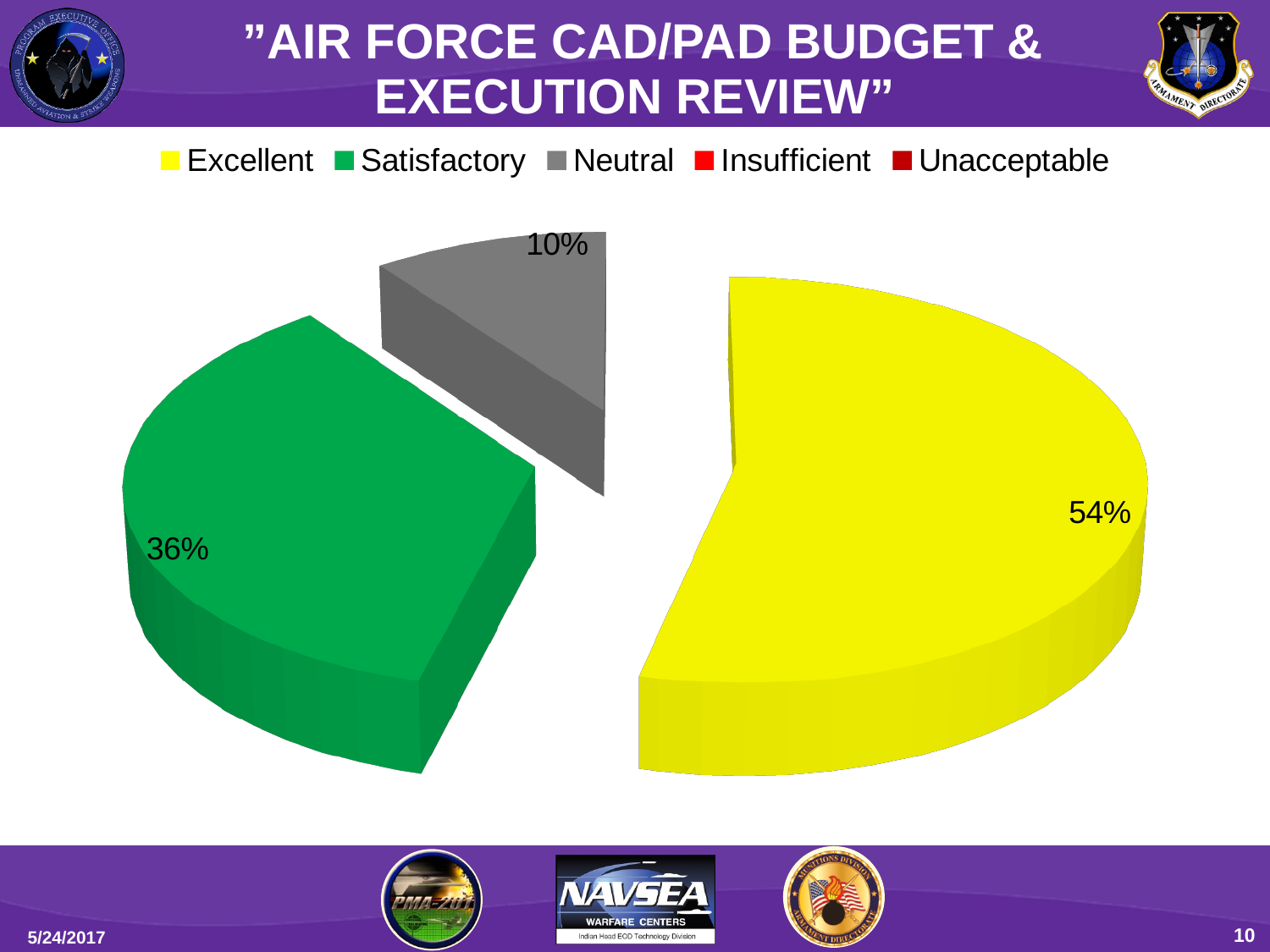
What is the difference in percentage points between the Satisfactory and Neutral slices? 26 Which is larger, the Satisfactory slice or the Neutral slice? Satisfactory Which category has the largest share of the pie? Excellent What percentage of the pie is labelled Excellent? 54% What colour is the Excellent slice? Yellow Which legend entry is shown in grey? Neutral What percentage of the pie is labelled Satisfactory? 36% What is the difference in percentage points between the Excellent and Satisfactory slices? 18 How many categories does the legend list? 5 What kind of chart is shown on the slide? Pie chart What percentage of the pie is labelled Neutral? 10% Which of the visible slices has the smallest share of the pie? Neutral